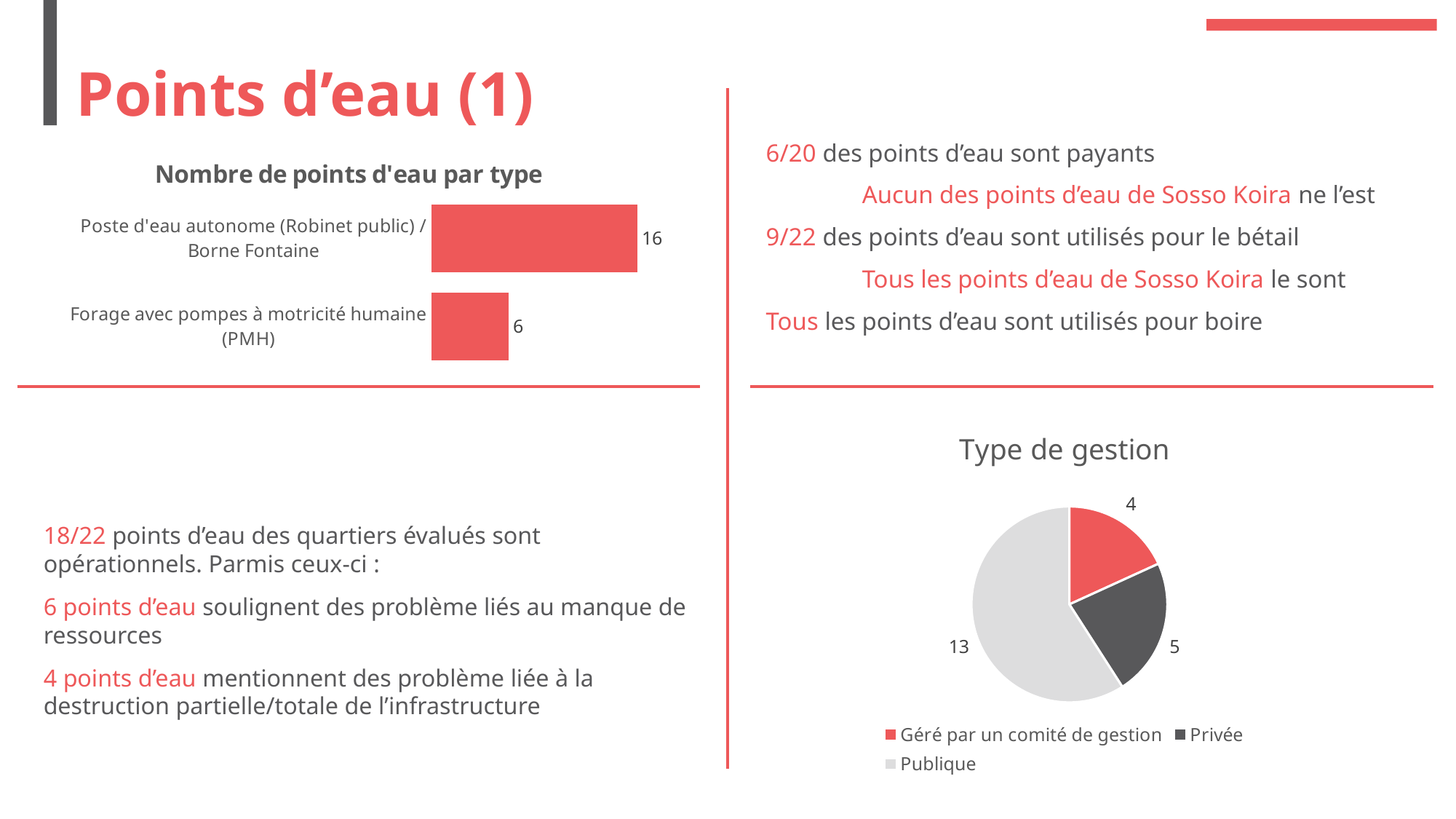
In the 'Type de gestion' chart, what is the value for Publique? 13 In the 'Type de gestion' chart, which category has the smallest slice? Géré par un comité de gestion What kind of chart is 'Nombre de points d'eau par type'? Bar chart In the chart 'Nombre de points d'eau par type', how many categories are shown? 2 In the chart 'Nombre de points d'eau par type', what is the difference between the two categories' values? 10 What kind of chart is 'Type de gestion'? Pie chart In the 'Type de gestion' chart, what is the value for Privée? 5 In the 'Type de gestion' chart, how many entries does the legend list? 3 In the 'Type de gestion' chart, what is the value for Géré par un comité de gestion? 4 In the chart 'Nombre de points d'eau par type', which category has the highest value? Poste d'eau autonome (Robinet public) / Borne Fontaine In the chart 'Nombre de points d'eau par type', what is the value for Forage avec pompes à motricité humaine (PMH)? 6 In the chart 'Nombre de points d'eau par type', what is the value for Poste d'eau autonome (Robinet public) / Borne Fontaine? 16